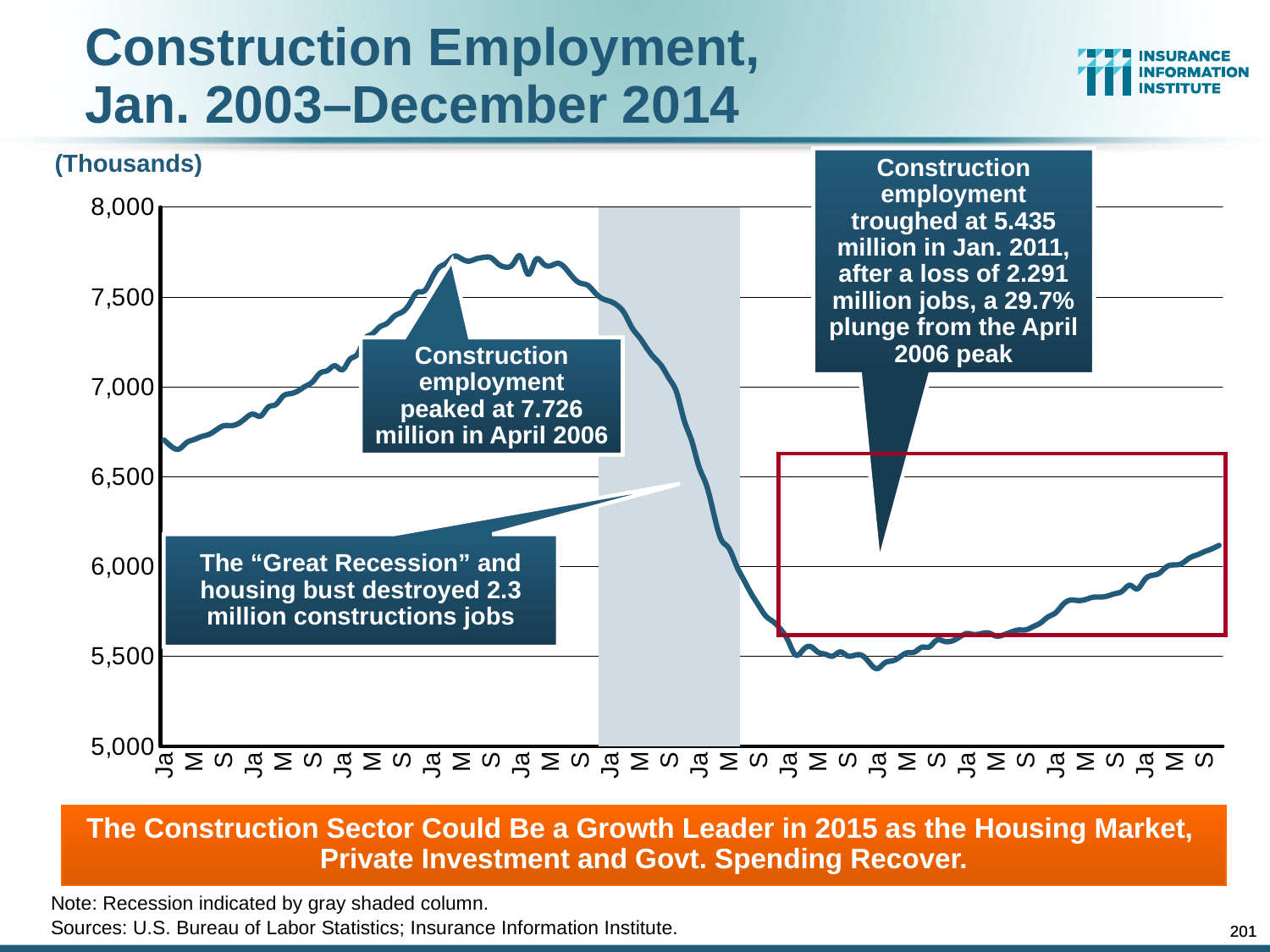
According to the chart's callout, at what level did construction employment peak in April 2006? 7.726 million What does the gray shaded column on the chart indicate? Recession Does construction employment rise or fall between the April 2006 peak and Jan. 2011? fall Is construction employment at the start of the series (Jan. 2003) greater or less than 6,500 thousand? greater According to the chart's callout, at what level did construction employment trough in Jan. 2011? 5.435 million In what units are the values on the y-axis expressed? Thousands How many jobs were lost between the April 2006 peak and the Jan. 2011 trough, as stated on the chart? 2.291 million Which is larger: construction employment in April 2006 or in Jan. 2011? April 2006 Is construction employment at the end of the series (late 2014) greater or less than 6,500 thousand? less What kind of chart is shown on the slide? line chart What percentage plunge from the April 2006 peak does the chart state for the Jan. 2011 trough? 29.7% Does construction employment rise or fall from Jan. 2011 to the end of 2014? rise